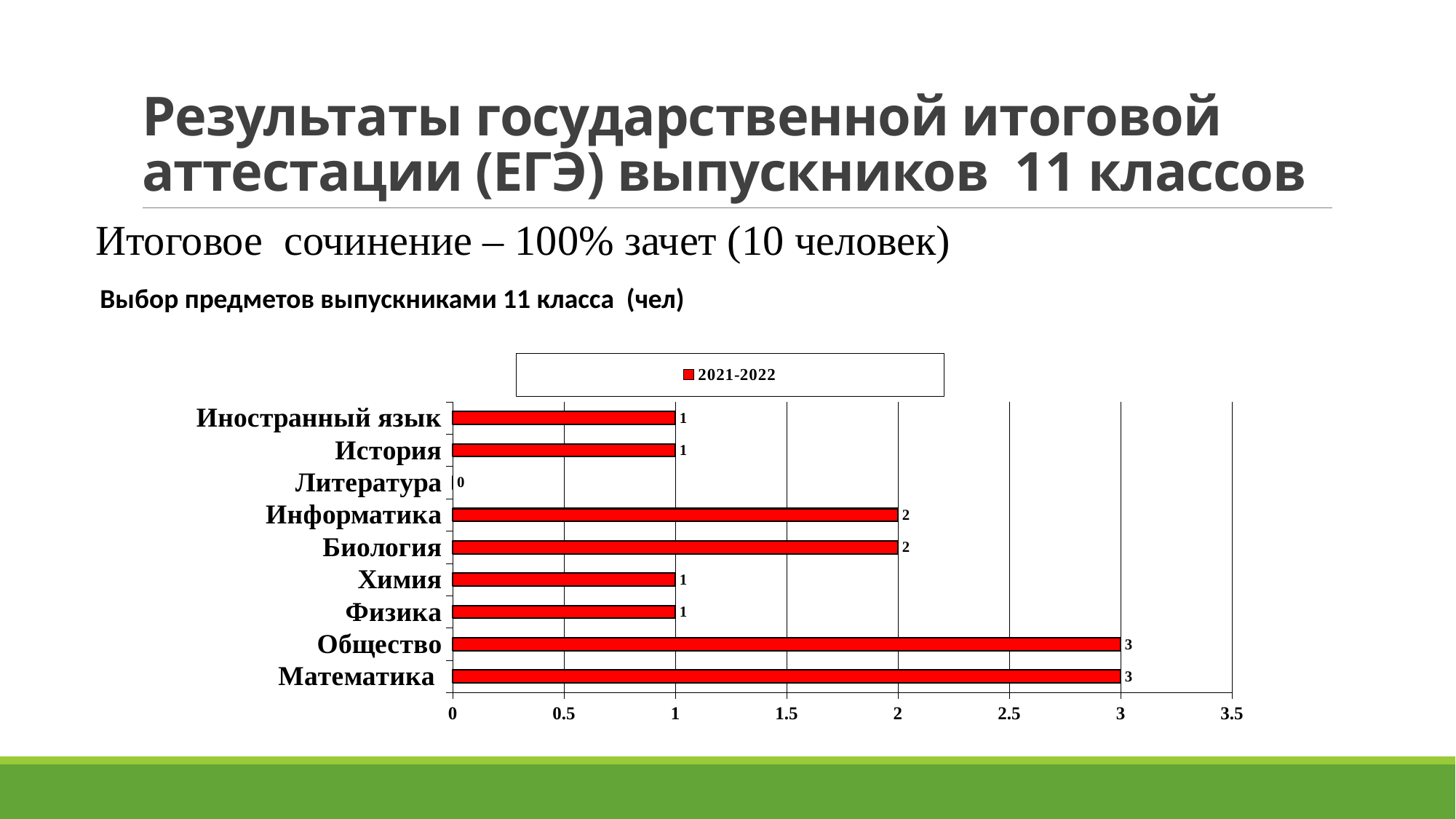
What is the value for Литература? 0 How many categories are shown on the chart? 9 Which category has the lowest value? Литература Is the value for Биология greater or less than 1.5? greater What is the value for Химия? 1 What is the total of the values for Математика and Общество? 6 What is the value for Информатика? 2 What series name is shown in the legend? 2021-2022 What kind of chart is shown on the slide? bar chart How many series does the legend list? 1 What is the difference between the values for Математика and Биология? 1 Which is larger, the value for Общество or the value for Физика? Общество